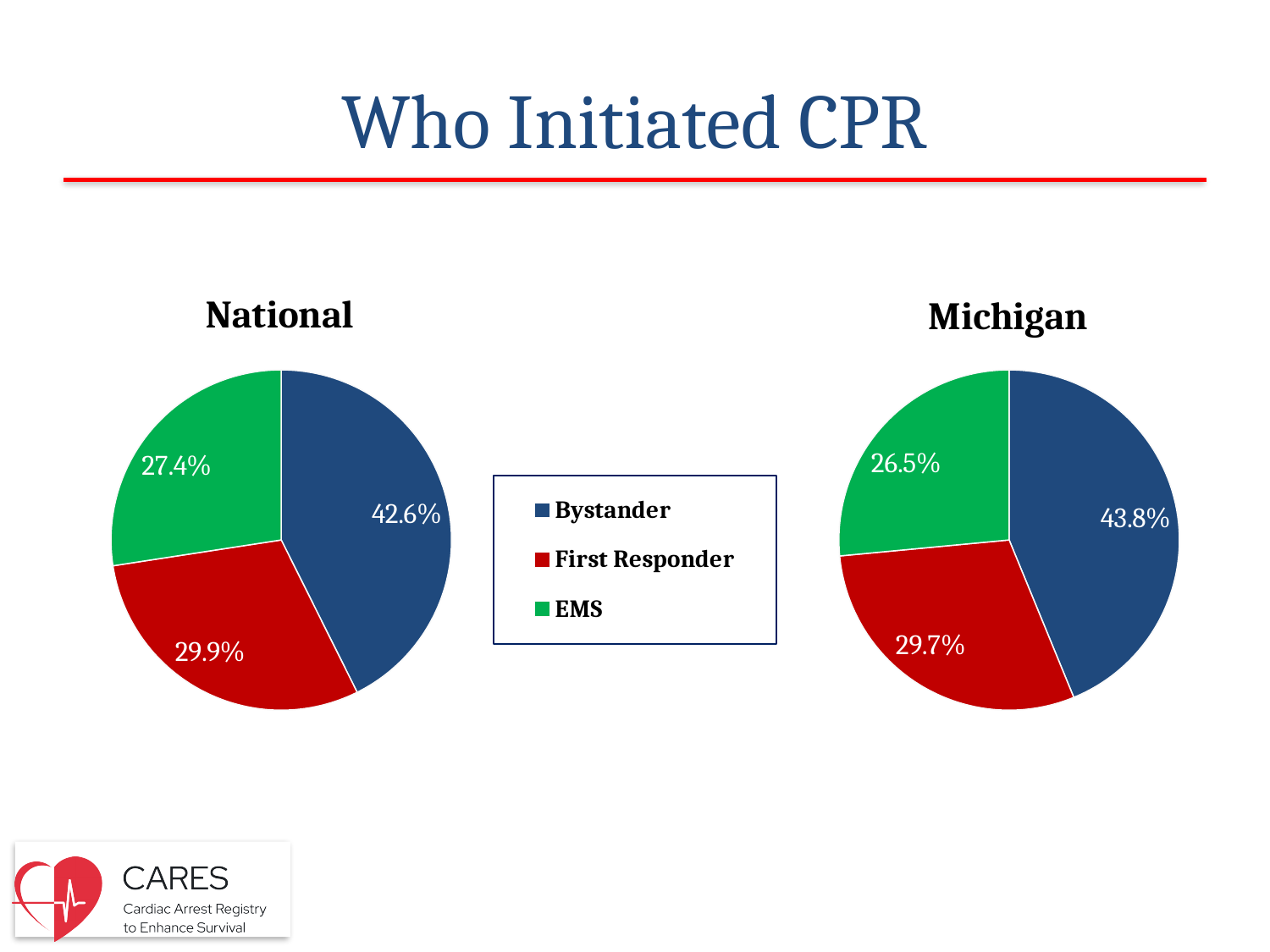
What type of chart is used for the National data? pie chart How many slices does the Michigan pie chart have? 3 In the Michigan pie chart, what share of CPR was initiated by EMS? 26.5% In the National pie chart, which category has the largest share? Bystander In the National pie chart, is the First Responder share larger or smaller than the EMS share? larger How many entries does the shared legend list? 3 In the National pie chart, what share of CPR was initiated by Bystanders? 42.6% In the Michigan pie chart, which category has the smallest share? EMS Is the Bystander share larger in the National chart or the Michigan chart? Michigan In the National pie chart, what is the difference between the Bystander share and the EMS share? 15.2% Which colour represents First Responder in the legend? red In the Michigan pie chart, what share of CPR was initiated by First Responders? 29.7%